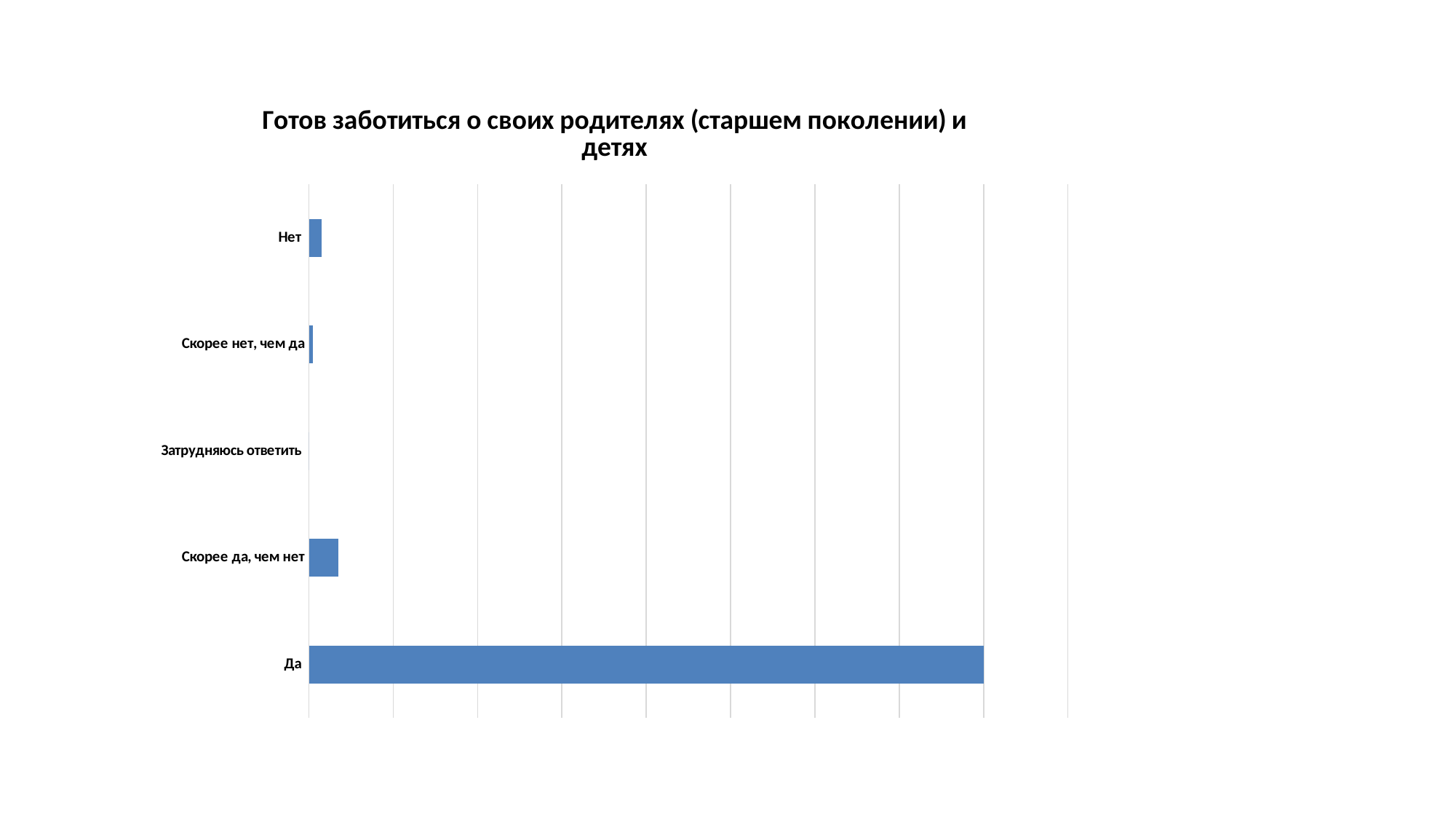
What colour are the bars on the chart? Blue Which category has the highest value? Да How many categories are shown on the chart? 5 Which is larger, the value for Скорее нет, чем да or the value for Затрудняюсь ответить? Скорее нет, чем да What is the title of the chart? Готов заботиться о своих родителях (старшем поколении) и детях Which is larger, the value for Да or the value for Скорее да, чем нет? Да Which category has the lowest value? Затрудняюсь ответить Which is larger, the value for Нет or the value for Скорее нет, чем да? Нет What kind of chart is shown on the slide? Bar chart